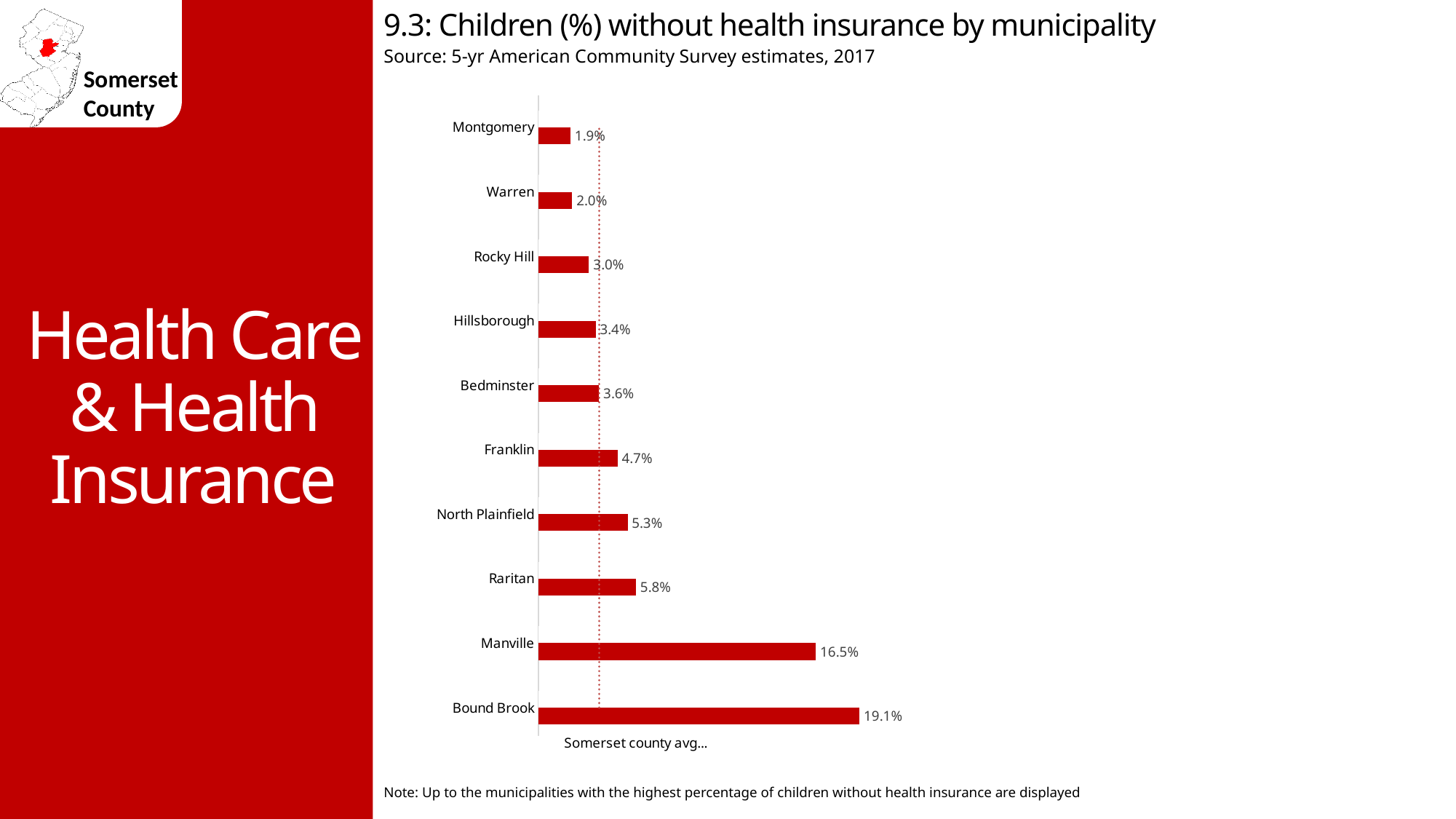
What is the difference between the values for Bound Brook and Manville? 2.6% Which municipality has the lowest percentage of children without health insurance? Montgomery What percentage is shown for Hillsborough? 3.4% How many municipalities are shown in the chart? 10 What is the difference between the values for Raritan and Franklin? 1.1% What is the value for North Plainfield? 5.3% What percentage of children in Bound Brook are without health insurance? 19.1% What type of chart is shown on the slide? Bar chart Which has a higher value, Rocky Hill or Bedminster? Bedminster Which municipality has the highest percentage of children without health insurance? Bound Brook What is the title of the chart? 9.3: Children (%) without health insurance by municipality What is the value shown for Manville? 16.5%